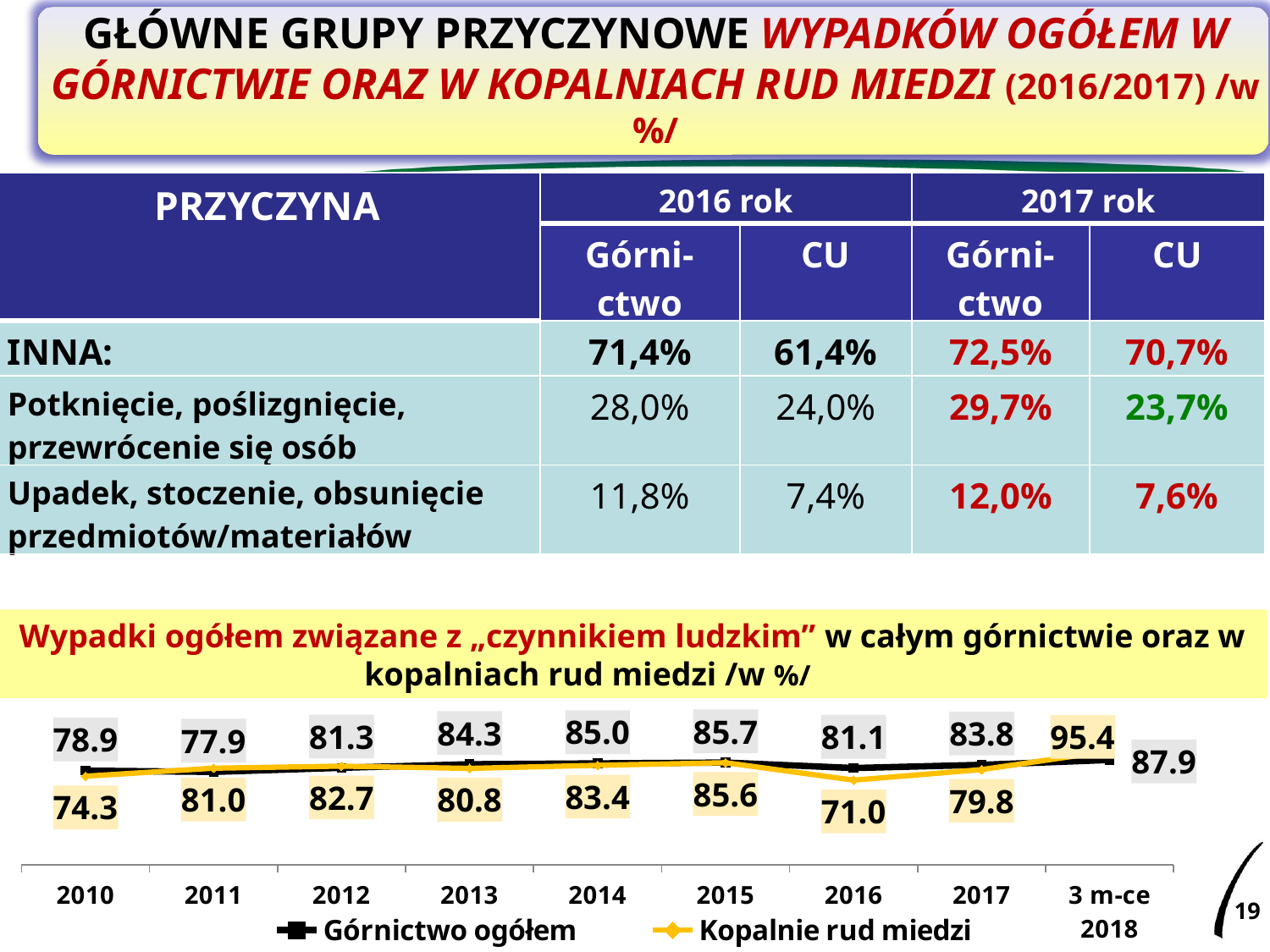
In the line chart, what is the value for Kopalnie rud miedzi for 3 m-ce 2018? 95.4 In the line chart, does the value for Kopalnie rud miedzi rise or fall from 2015 to 2016? fall How many series does the legend of the line chart list? 2 How many points along the x axis does the line chart have? 9 In the line chart, which series has the larger value in 2011, Górnictwo ogółem or Kopalnie rud miedzi? Kopalnie rud miedzi In the line chart, what is the value for Górnictwo ogółem in 2014? 85.0 In the line chart, what is the value for Kopalnie rud miedzi in 2016? 71.0 In the line chart, what is the difference between Górnictwo ogółem and Kopalnie rud miedzi in 2016? 10.1 What type of chart is shown at the bottom of the slide? line chart In the line chart, which x-axis point has the highest value for Górnictwo ogółem? 3 m-ce 2018 In the line chart, which x-axis point has the lowest value for Kopalnie rud miedzi? 2016 Which colour is used for the Kopalnie rud miedzi series in the line chart? yellow